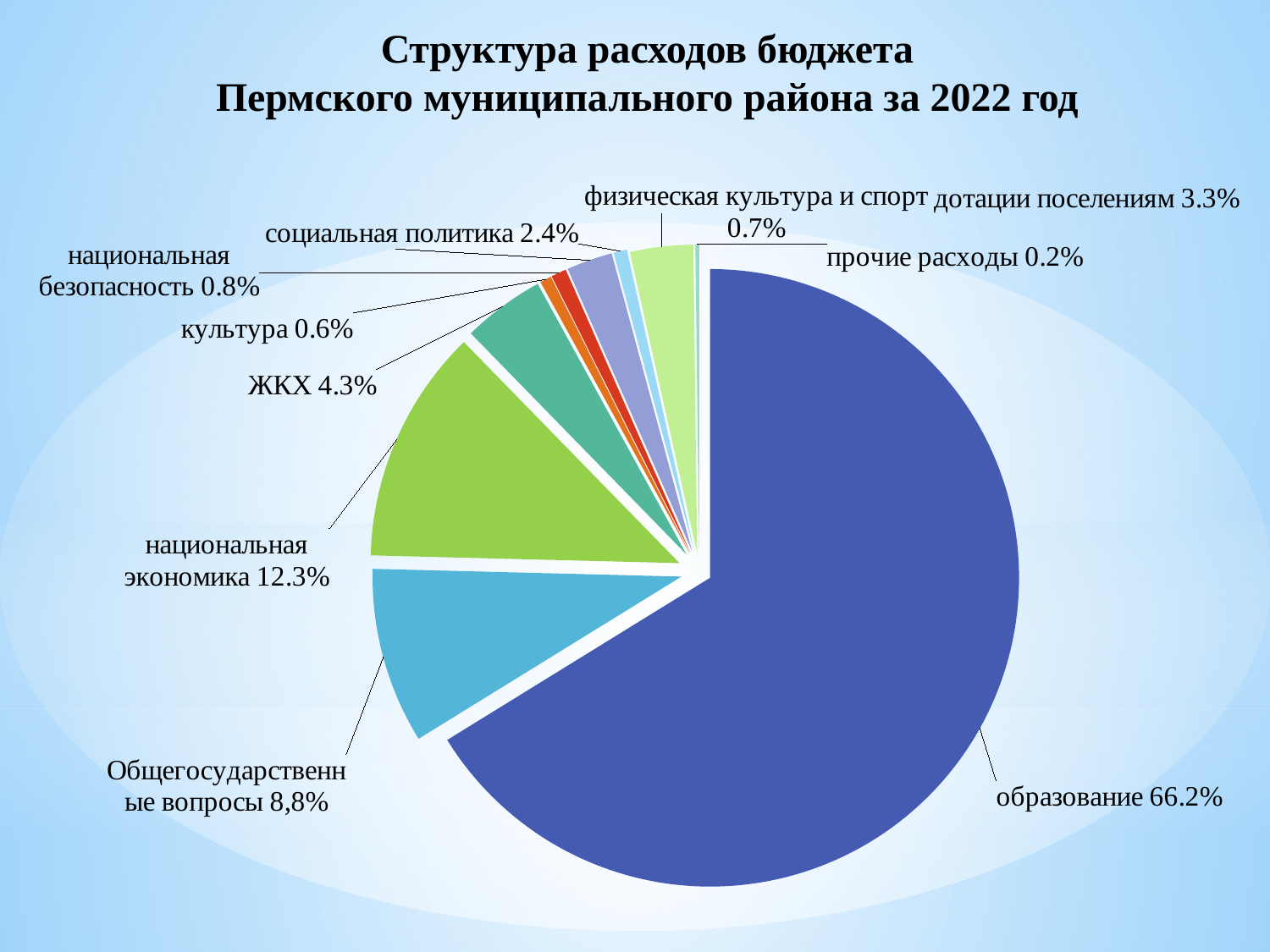
What is the difference between the shares of образование and национальная экономика? 53.9% What is the value shown for национальная экономика? 12.3% What kind of chart is shown on the slide? pie chart Which category has the smallest share of the pie? прочие расходы Which category has the largest share of the pie? образование What is the value shown for дотации поселениям? 3.3% What is the value shown for ЖКХ? 4.3% What share of budget expenditure goes to образование? 66.2% Which is larger, социальная политика or ЖКХ? ЖКХ What is the value shown for Общегосударственные вопросы? 8,8% What is the value shown for прочие расходы? 0.2% How many categories are shown in the pie chart? 10